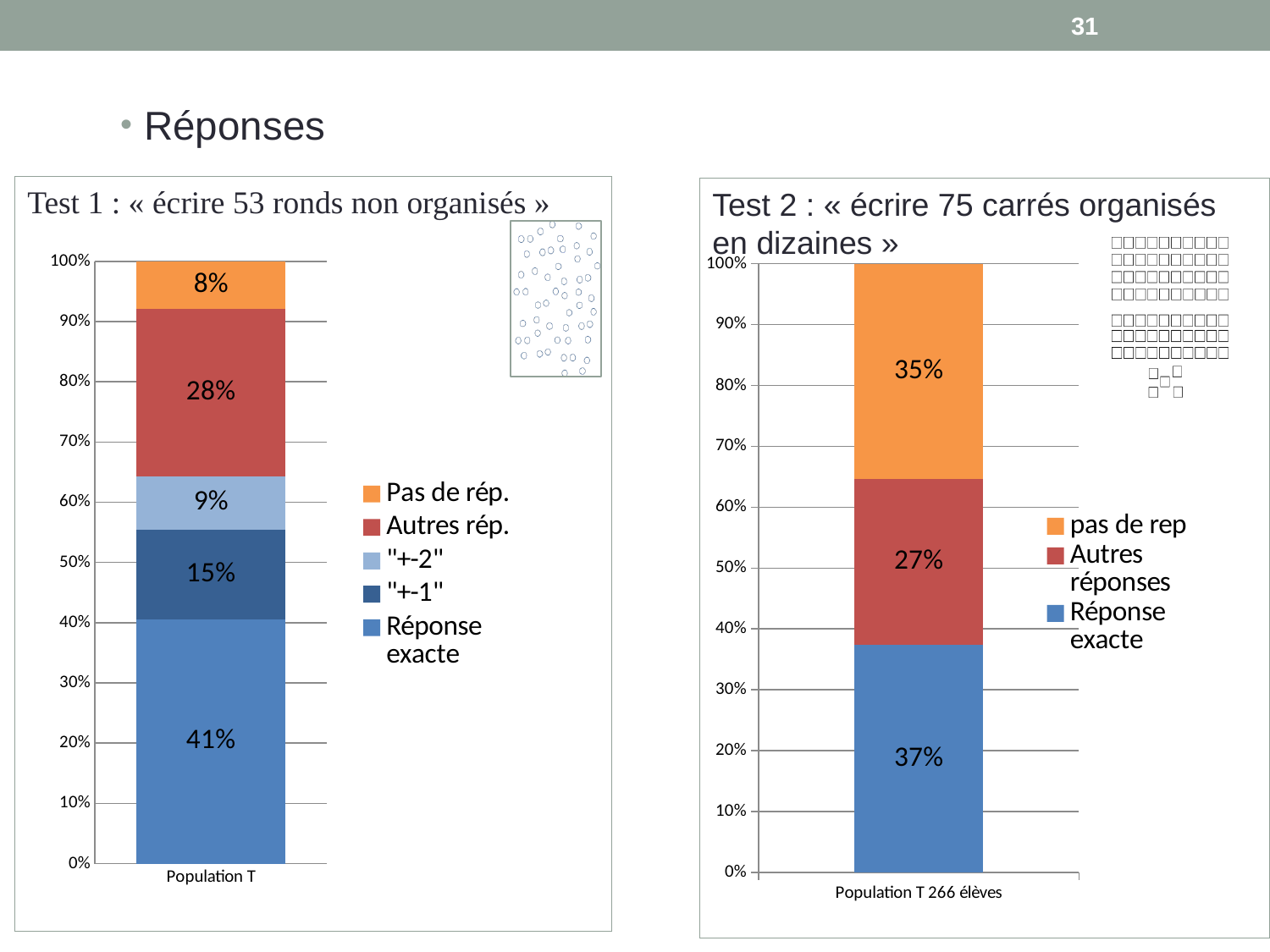
In the Test 2 chart, which is larger, "Autres réponses" or "Réponse exacte"? Réponse exacte In the Test 1 chart, which legend category has the smallest segment? Pas de rép. In the Test 1 chart, what is the difference between the "Réponse exacte" and "Autres rép." percentages? 13% In the Test 1 chart, what percentage is shown for "Autres rép."? 28% What is the x-axis category label in the Test 2 chart? Population T 266 élèves In the Test 1 chart, what percentage is shown for "Réponse exacte"? 41% What type of chart is the Test 2 chart? Stacked bar chart In the Test 2 chart, what percentage is shown for "Réponse exacte"? 37% In the Test 2 chart, what percentage is shown for "pas de rep"? 35% In the Test 2 chart, what is the difference between the "pas de rep" and "Autres réponses" percentages? 8% In the Test 1 chart, how many series does the legend list? 5 In the Test 1 chart, what percentage is shown for "+-1"? 15%